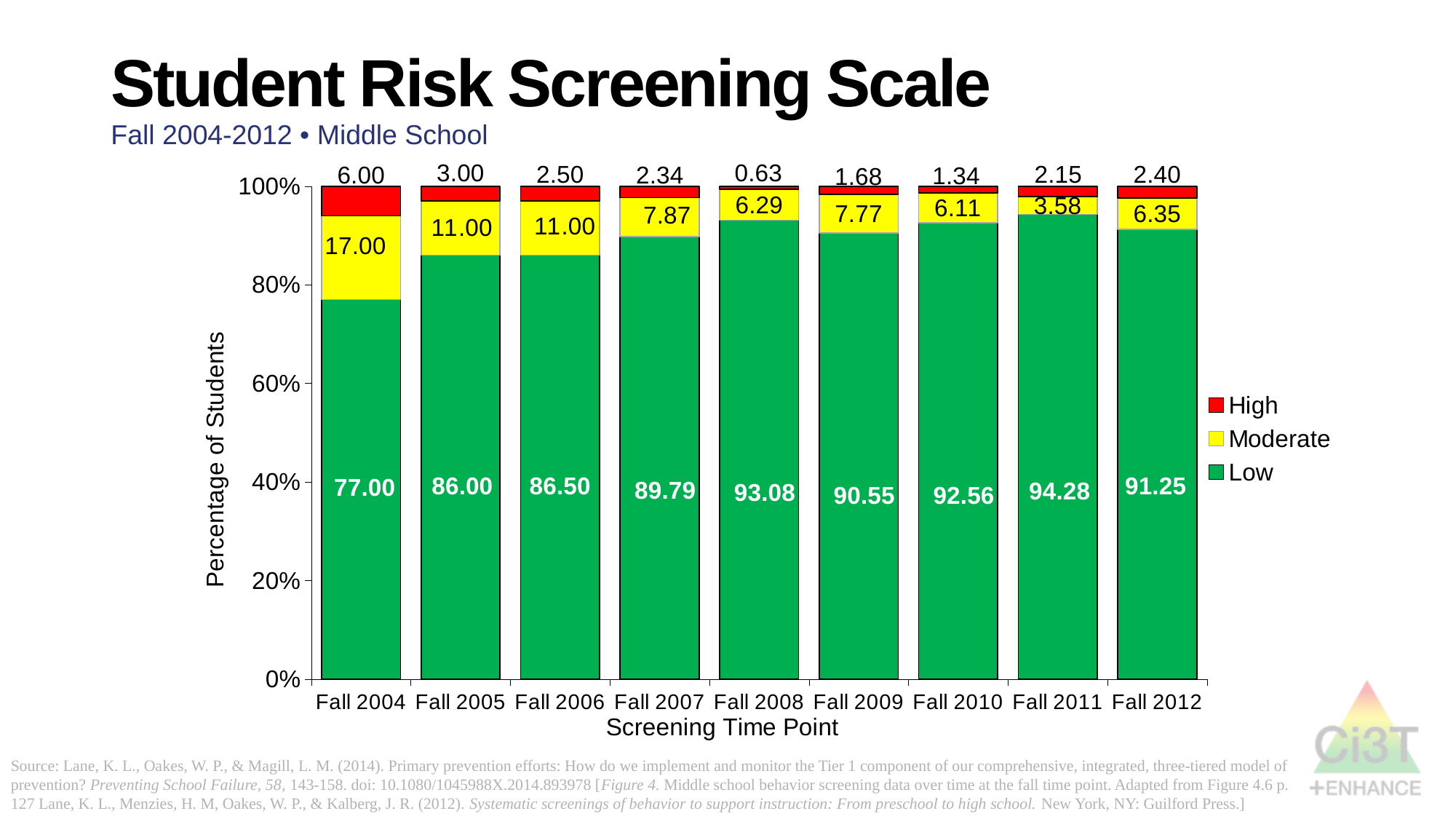
Which screening time point has the lowest Moderate value? Fall 2011 Does the High value generally rise or fall from Fall 2004 to Fall 2012? Fall How many series does the legend list? 3 Which is larger, the Moderate value for Fall 2009 or the Moderate value for Fall 2010? Fall 2009 What kind of chart is shown on the slide? Stacked bar chart What is the High value for Fall 2008? 0.63 What is the Low value for Fall 2004? 77.00 How many screening time points are shown on the x axis? 9 Which screening time point has the lowest High value? Fall 2008 What is the Moderate value for Fall 2007? 7.87 Which screening time point has the highest Low value? Fall 2011 What is the difference between the Low value for Fall 2011 and the Low value for Fall 2004? 17.28